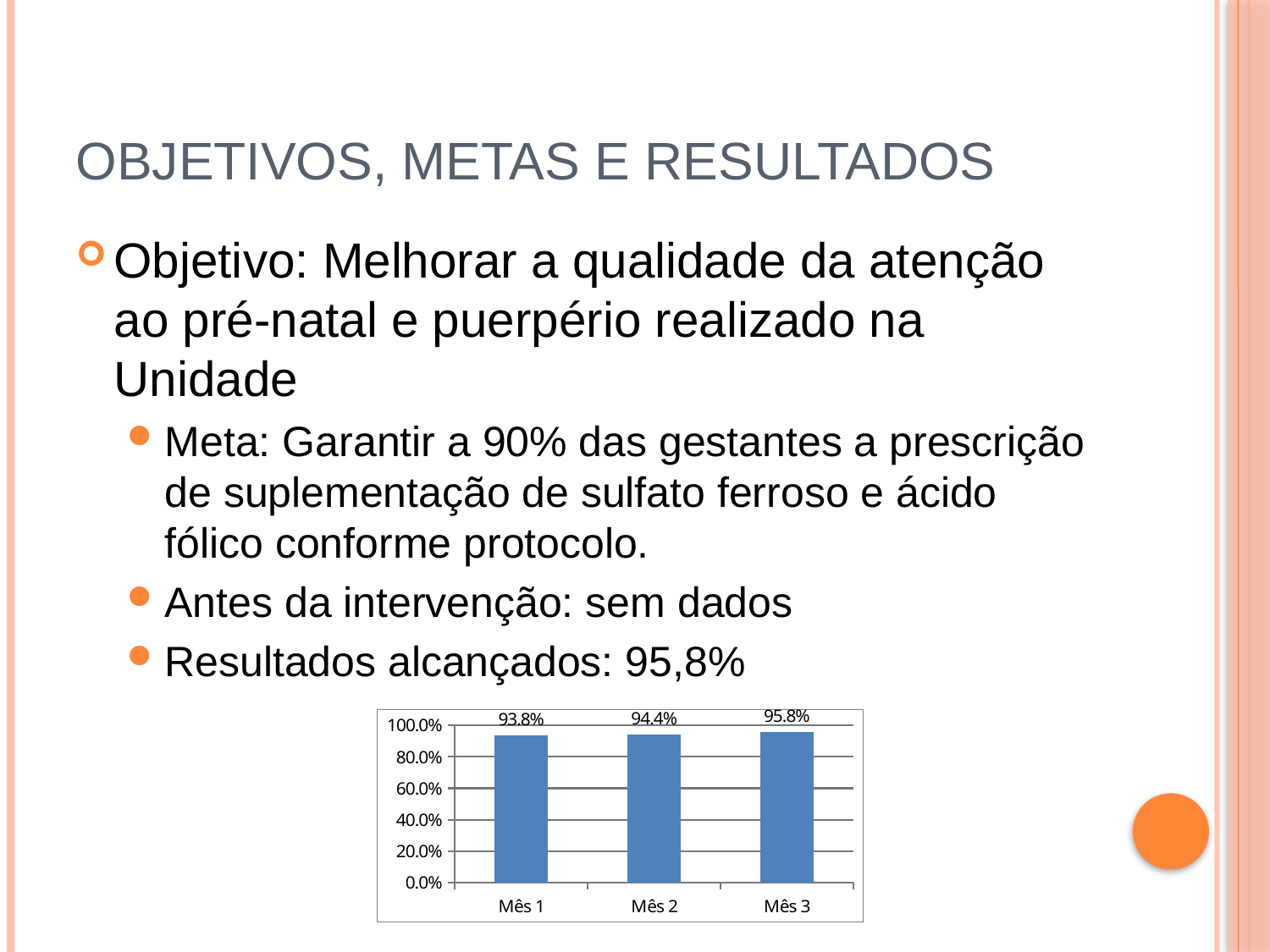
What is the value for Mês 3? 95.8% What is the difference between the values for Mês 2 and Mês 1? 0.6% What is the value for Mês 2? 94.4% What is the value for Mês 1? 93.8% What is the difference between the values for Mês 3 and Mês 1? 2.0% Which month has the highest value? Mês 3 How many categories are shown on the x axis? 3 Do the values rise or fall from Mês 1 to Mês 3? rise Which is larger, the value for Mês 2 or the value for Mês 3? Mês 3 Is the value for Mês 1 greater or less than 80.0%? greater What kind of chart is shown on the slide? bar chart Which month has the lowest value? Mês 1